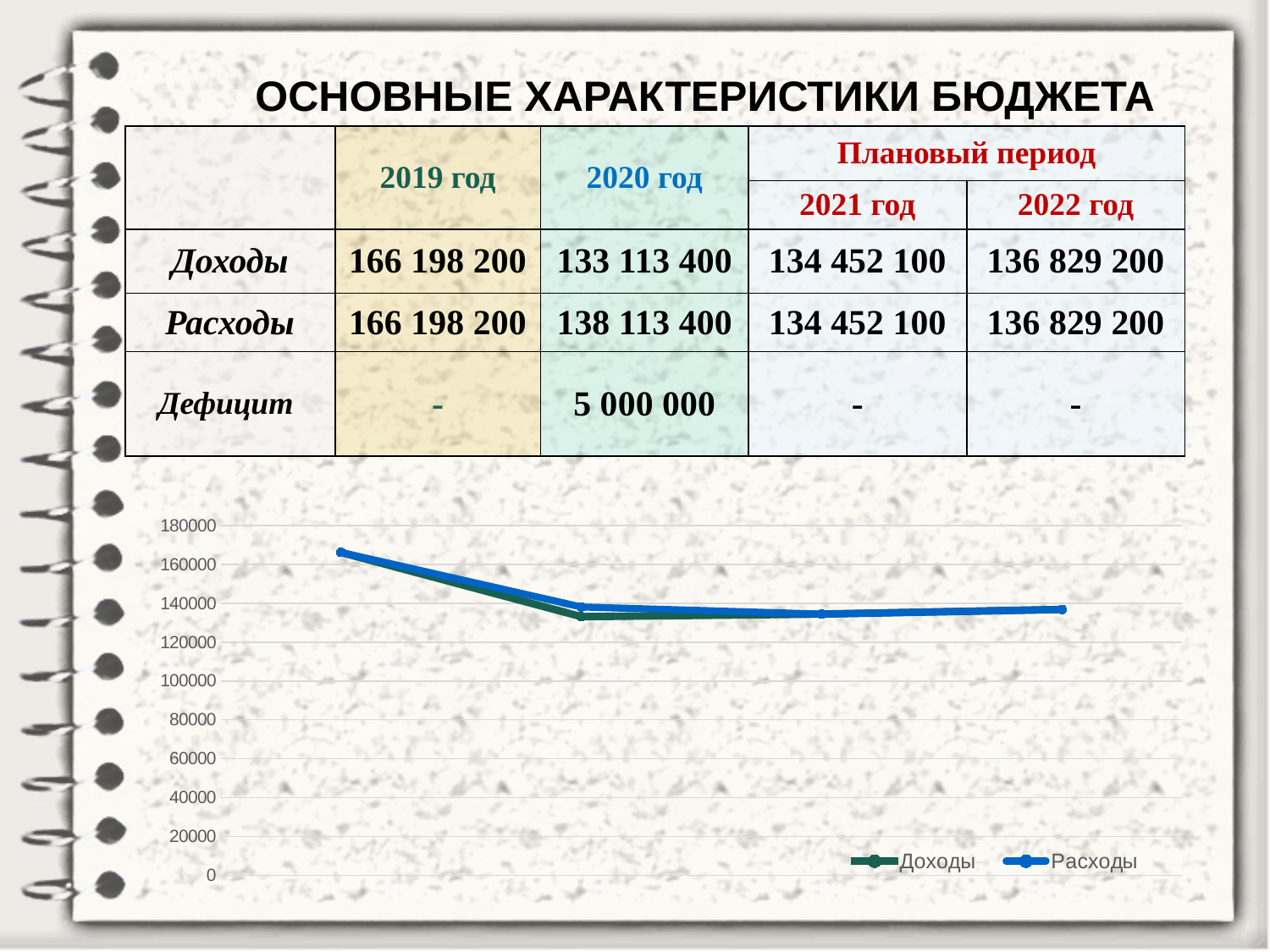
Is the value of the last point of the Расходы line greater or less than 120000? greater What are the two series named in the chart legend? Доходы and Расходы Which data point of the Доходы line is the highest? the first point What colour is the Расходы line in the chart? blue What kind of chart is shown on the slide? line chart How many data points does each line in the chart have? 4 Is the value of the first point of the Расходы line greater or less than 160000? greater Do the values of the Доходы line rise or fall from the first point to the second point? fall How many series does the chart legend list? 2 At the second data point, which line is higher, Доходы or Расходы? Расходы What is the highest value shown on the chart's vertical axis? 180000 Is the value of the second point of the Доходы line greater or less than 140000? less